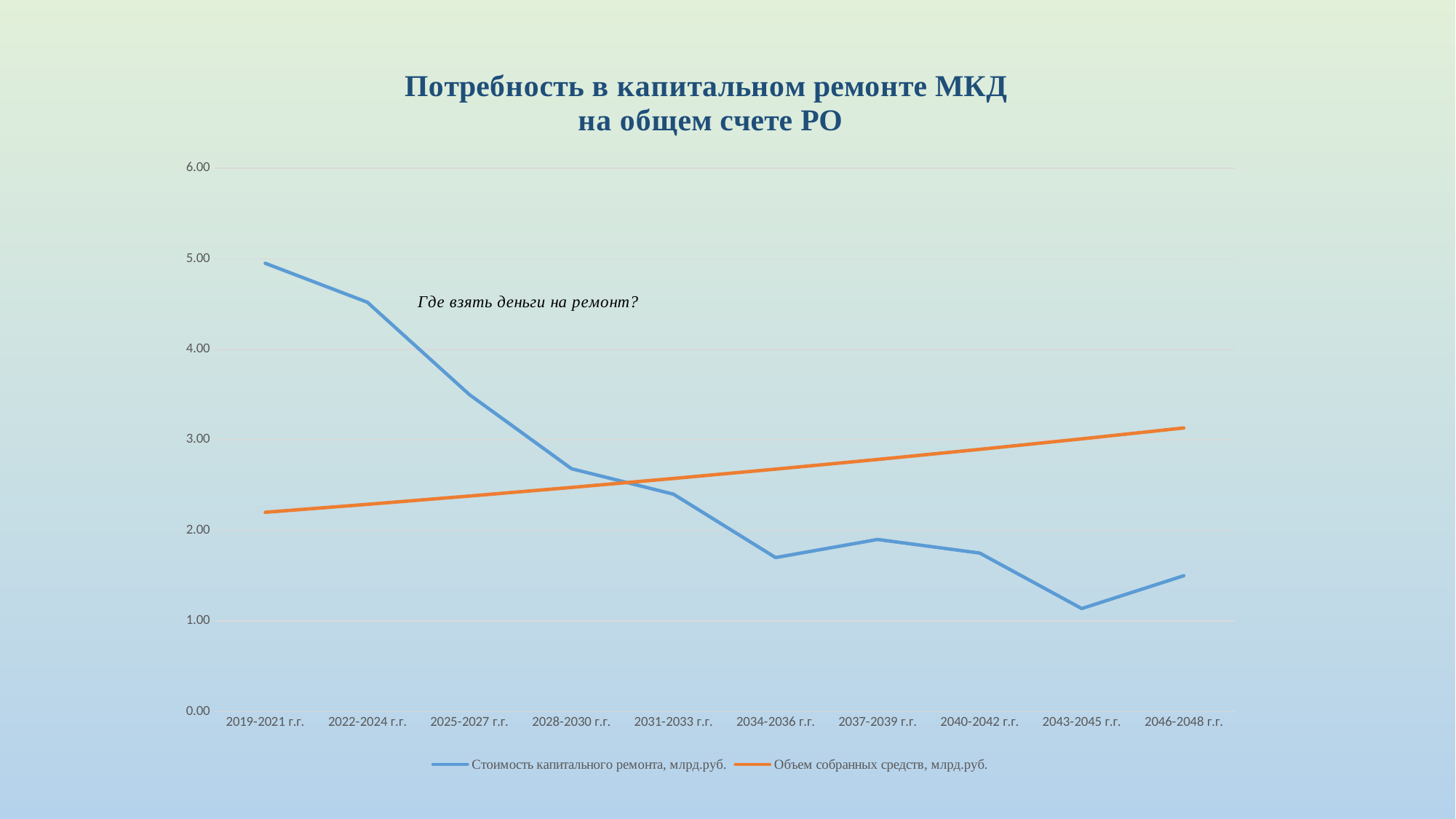
Is the value of 'Стоимость капитального ремонта, млрд.руб.' for 2019-2021 г.г. greater or less than 4.00? greater For 2046-2048 г.г., which series has the higher value? Объем собранных средств, млрд.руб. Does the series 'Стоимость капитального ремонта, млрд.руб.' generally rise or fall from 2019-2021 г.г. to 2046-2048 г.г.? Fall What kind of chart is shown on the slide? Line chart In which period is 'Стоимость капитального ремонта, млрд.руб.' highest? 2019-2021 г.г. Is the value of 'Объем собранных средств, млрд.руб.' for 2019-2021 г.г. greater or less than 3.00? less In which period is 'Стоимость капитального ремонта, млрд.руб.' lowest? 2043-2045 г.г. Does the series 'Объем собранных средств, млрд.руб.' rise or fall from 2019-2021 г.г. to 2046-2048 г.г.? Rise How many series does the legend list? 2 How many periods are shown along the x axis? 10 What is the title of the chart? Потребность в капитальном ремонте МКД на общем счете РО For 2019-2021 г.г., which series has the higher value? Стоимость капитального ремонта, млрд.руб.